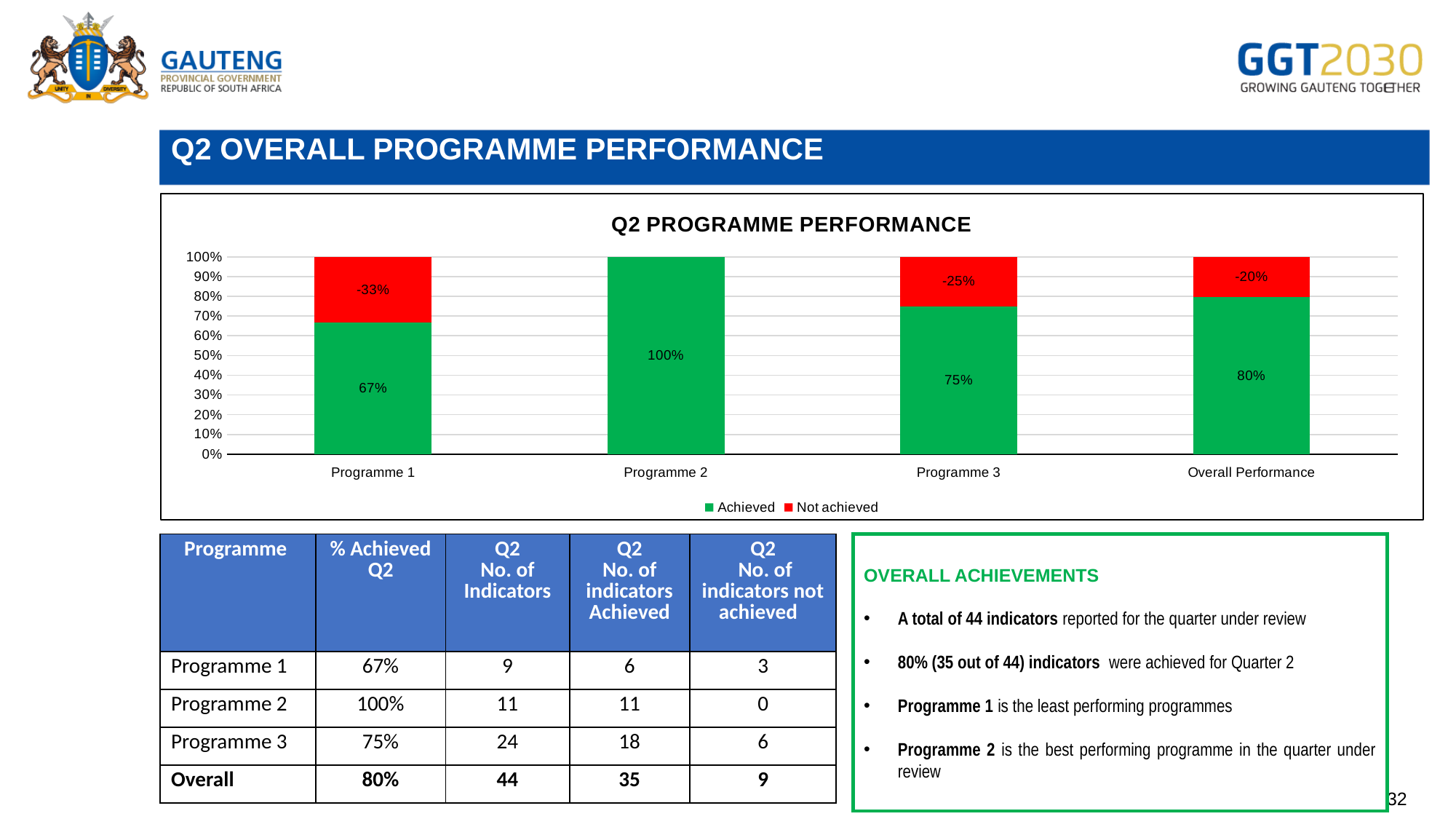
What is the difference between the Achieved values for Programme 2 and Programme 1 in the Q2 PROGRAMME PERFORMANCE chart? 33% What is the Achieved value for Programme 1 in the Q2 PROGRAMME PERFORMANCE chart? 67% How many series does the legend of the Q2 PROGRAMME PERFORMANCE chart list? 2 What data label is shown on the Not achieved segment for Programme 1 in the Q2 PROGRAMME PERFORMANCE chart? -33% What is the Achieved value for Overall Performance in the Q2 PROGRAMME PERFORMANCE chart? 80% Which category has the highest Achieved value in the Q2 PROGRAMME PERFORMANCE chart? Programme 2 Which category has the lowest Achieved value in the Q2 PROGRAMME PERFORMANCE chart? Programme 1 What is the Achieved value for Programme 3 in the Q2 PROGRAMME PERFORMANCE chart? 75% How many categories are shown on the x axis of the Q2 PROGRAMME PERFORMANCE chart? 4 Which has a larger Achieved value in the Q2 PROGRAMME PERFORMANCE chart, Programme 3 or Overall Performance? Overall Performance What data label is shown on the Not achieved segment for Programme 3 in the Q2 PROGRAMME PERFORMANCE chart? -25% What type of chart is the Q2 PROGRAMME PERFORMANCE chart? Stacked bar chart